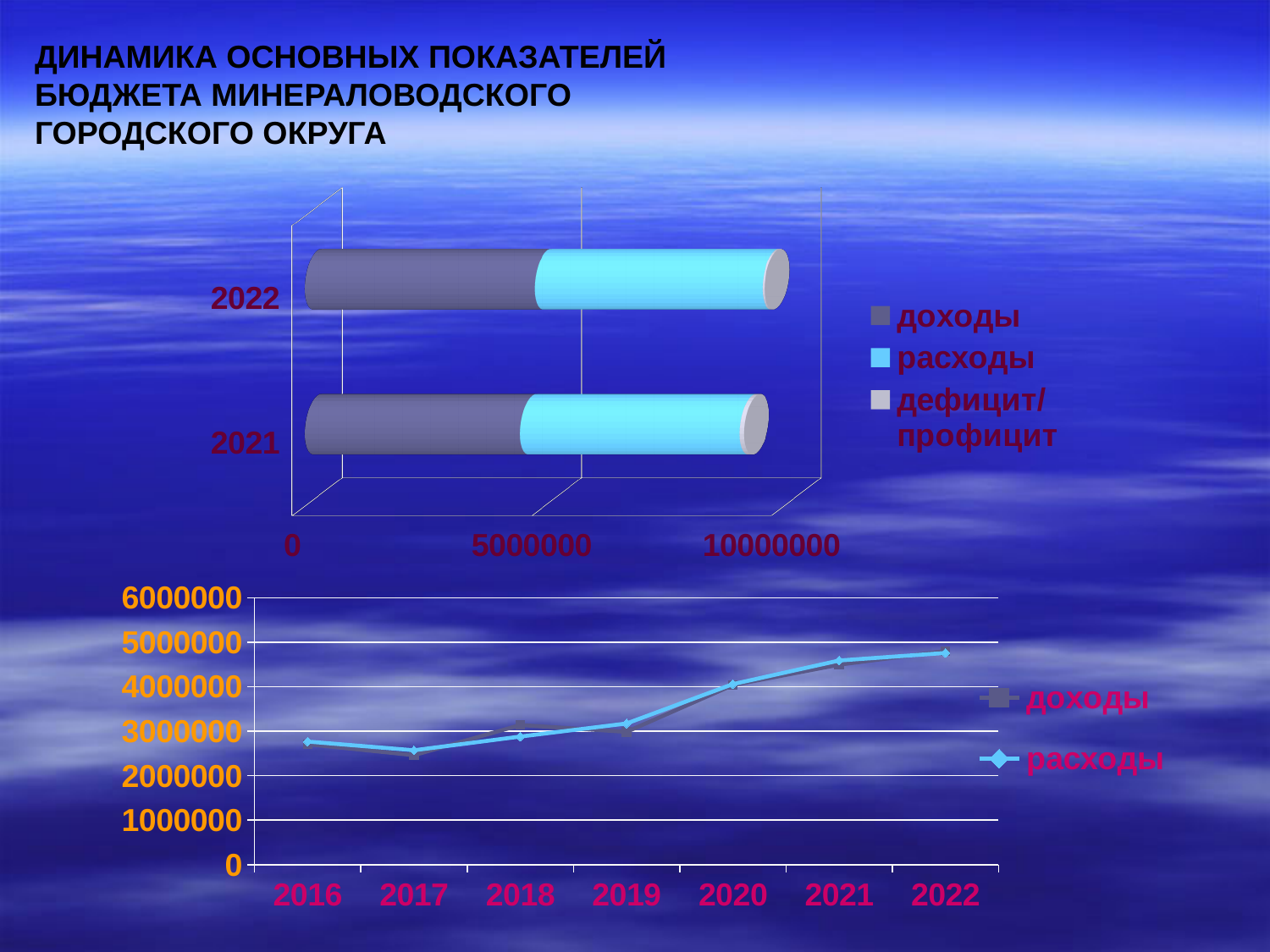
What kind of chart is the bottom chart on the slide? line chart In the bottom chart, is the value of доходы for 2017 greater or less than 2000000? greater In the bottom chart, is the value of расходы for 2022 greater or less than 4000000? greater In the bottom chart, is the value of расходы for 2016 greater or less than 3000000? less How many series does the legend of the top chart list? 3 In the bottom chart, do the values of расходы generally rise or fall from 2016 to 2022? rise In the bottom chart, which is larger: расходы in 2022 or расходы in 2016? 2022 How many years are shown on the x axis of the bottom chart? 7 What kind of chart is the top chart on the slide? bar chart How many years are shown in the top chart? 2 How many series does the legend of the bottom chart list? 2